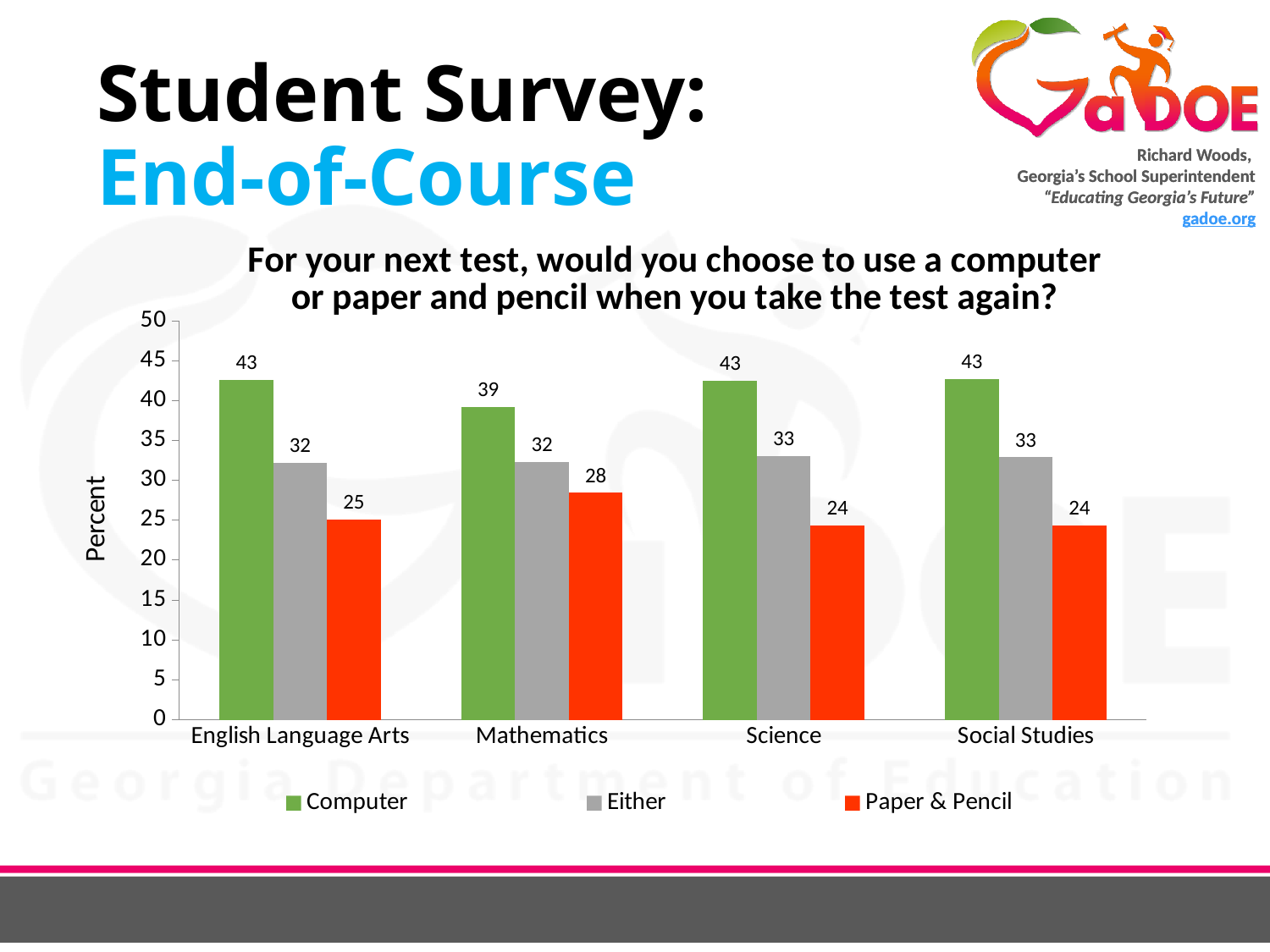
Which is larger in Mathematics, the Either value or the Paper & Pencil value? Either Which subject has the lowest value for Computer? Mathematics What kind of chart is shown on the slide? Bar chart What is the value for Paper & Pencil in English Language Arts? 25 Which subject has the highest value for Paper & Pencil? Mathematics What is the value for Either in Science? 33 What is the difference between the Computer and Paper & Pencil values for Social Studies? 19 Which colour represents the Paper & Pencil series? Orange-red What is the label of the y axis? Percent How many series does the legend list? 3 What is the value for Computer in Mathematics? 39 How many subjects are shown on the x axis? 4